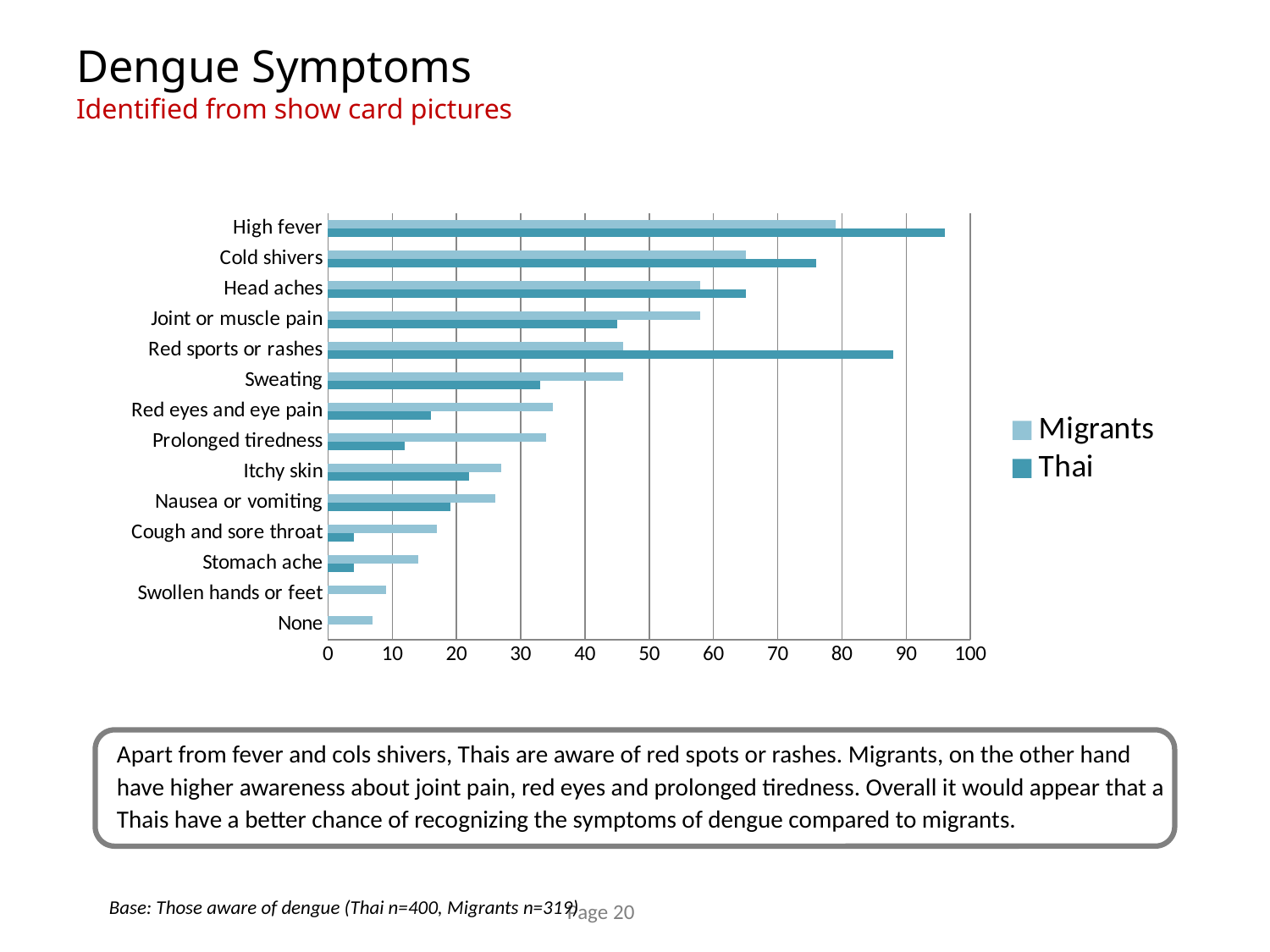
What kind of chart is shown on the slide? bar chart How many symptom categories are plotted on the chart? 14 Is the Thai value for Prolonged tiredness greater or less than 20? less Which symptom has the highest value for Thai? High fever What are the two legend entries on the chart? Migrants and Thai Is the Migrants value for Red sports or rashes greater or less than 50? less Which symptom has the highest value for Migrants? High fever For Red sports or rashes, which series has the larger value, Migrants or Thai? Thai For Red eyes and eye pain, which series has the larger value, Migrants or Thai? Migrants Is the Thai value for High fever greater or less than 90? greater How many series does the legend list? 2 Which category has the lowest value for Migrants? None